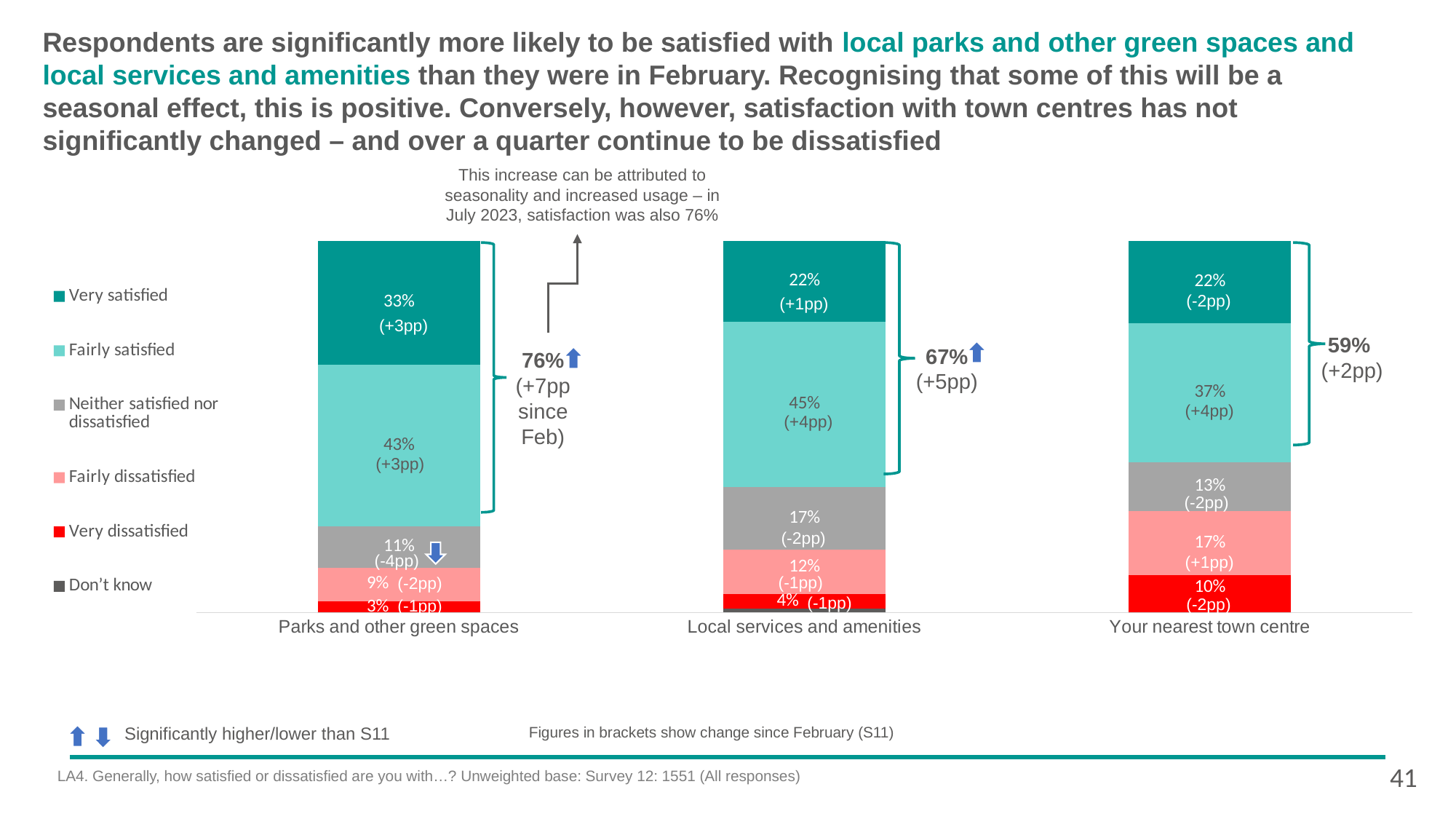
How many categories are shown on the x axis of the chart? 3 What percentage of respondents are very dissatisfied with their nearest town centre? 10% What is the difference between the combined satisfied percentages for parks and other green spaces and your nearest town centre? 17 percentage points Which category has the lowest very dissatisfied percentage? Parks and other green spaces What kind of chart is shown on the slide? Stacked bar chart What is the combined satisfied percentage shown for local services and amenities? 67% What percentage of respondents are very satisfied with parks and other green spaces? 33% Which is larger: the fairly dissatisfied percentage for local services and amenities or for your nearest town centre? Your nearest town centre How many series does the legend list? 6 What percentage of respondents are fairly satisfied with local services and amenities? 45% Which category has the highest combined satisfied percentage? Parks and other green spaces What change since February is shown in brackets for the fairly satisfied segment of your nearest town centre? +4pp